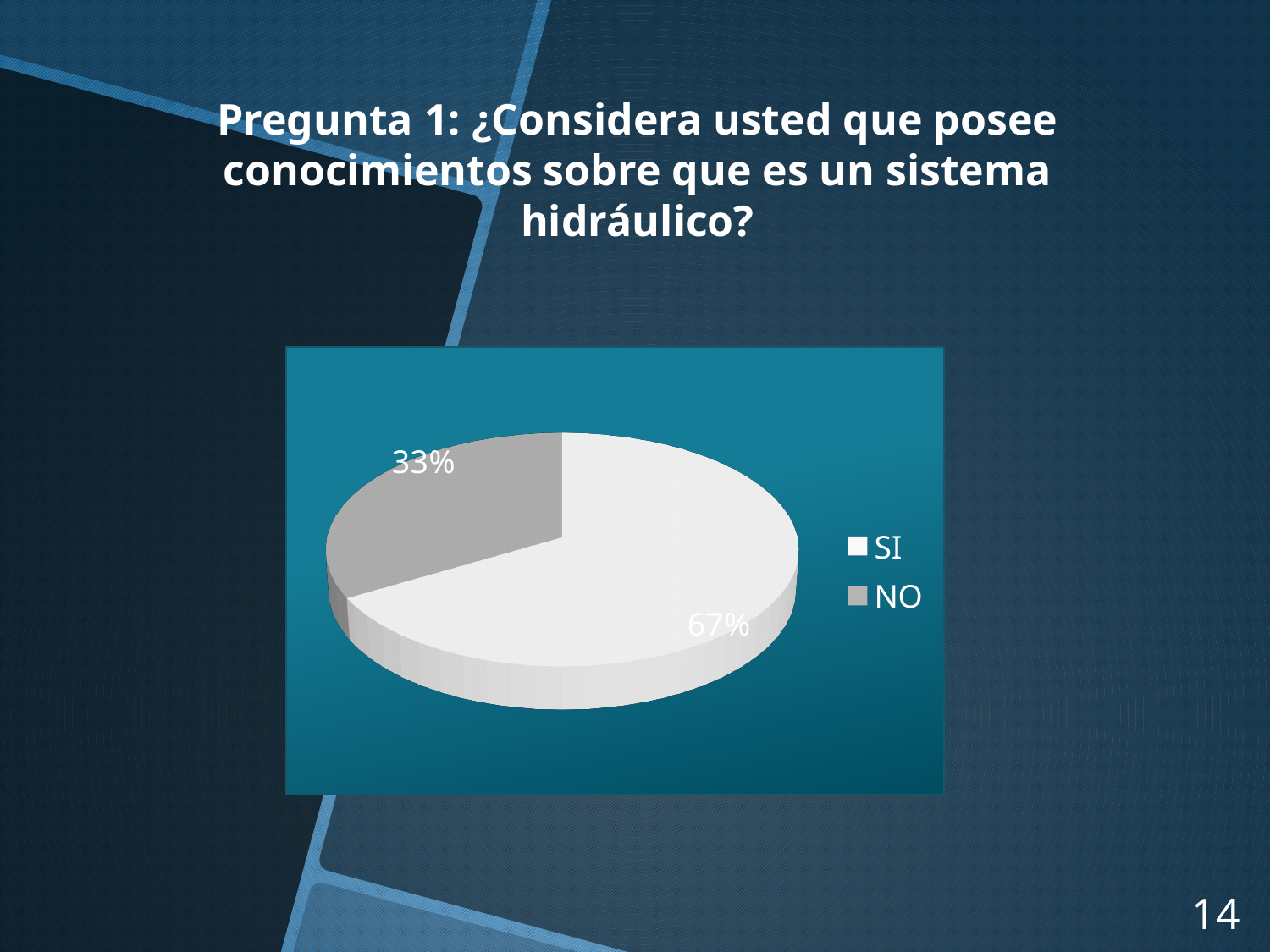
What is the difference in percentage points between the SI and NO slices? 34 How many entries does the legend list? 2 Which is larger, the SI slice or the NO slice? SI Is the value for NO greater or less than 50%? less How many slices does the pie chart have? 2 Which slice is the largest in the pie chart? SI What share of the pie does the NO slice represent? 33% Which slice is the smallest in the pie chart? NO Which legend entry is shown in the darker grey colour? NO Is the value for SI greater or less than 50%? greater What kind of chart is shown on the slide? pie chart What share of the pie does the SI slice represent? 67%